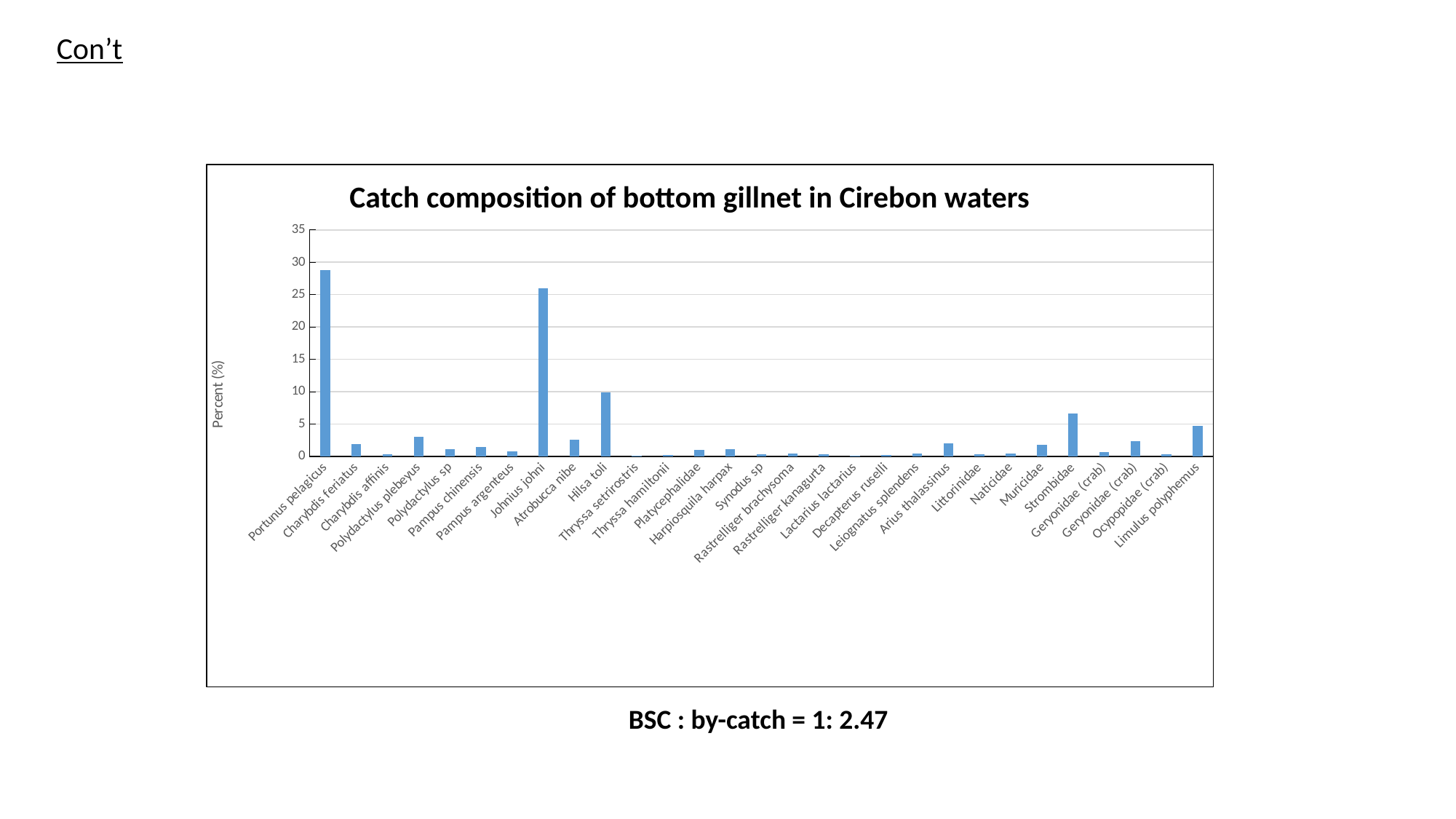
Is the value for Portunus pelagicus greater or less than 25? greater Is the value for Polydactylus plebeyus greater or less than 5? less Which category has the highest value? Portunus pelagicus Which is larger, the value for Portunus pelagicus or the value for Johnius johni? Portunus pelagicus Is the value for Hilsa toli greater or less than 5? greater What is the title of the chart? Catch composition of bottom gillnet in Cirebon waters How many categories are plotted on the x axis? 29 What kind of chart is shown on the slide? bar chart Which is larger, the value for Hilsa toli or the value for Strombidae? Hilsa toli What is the label of the vertical axis? Percent (%)